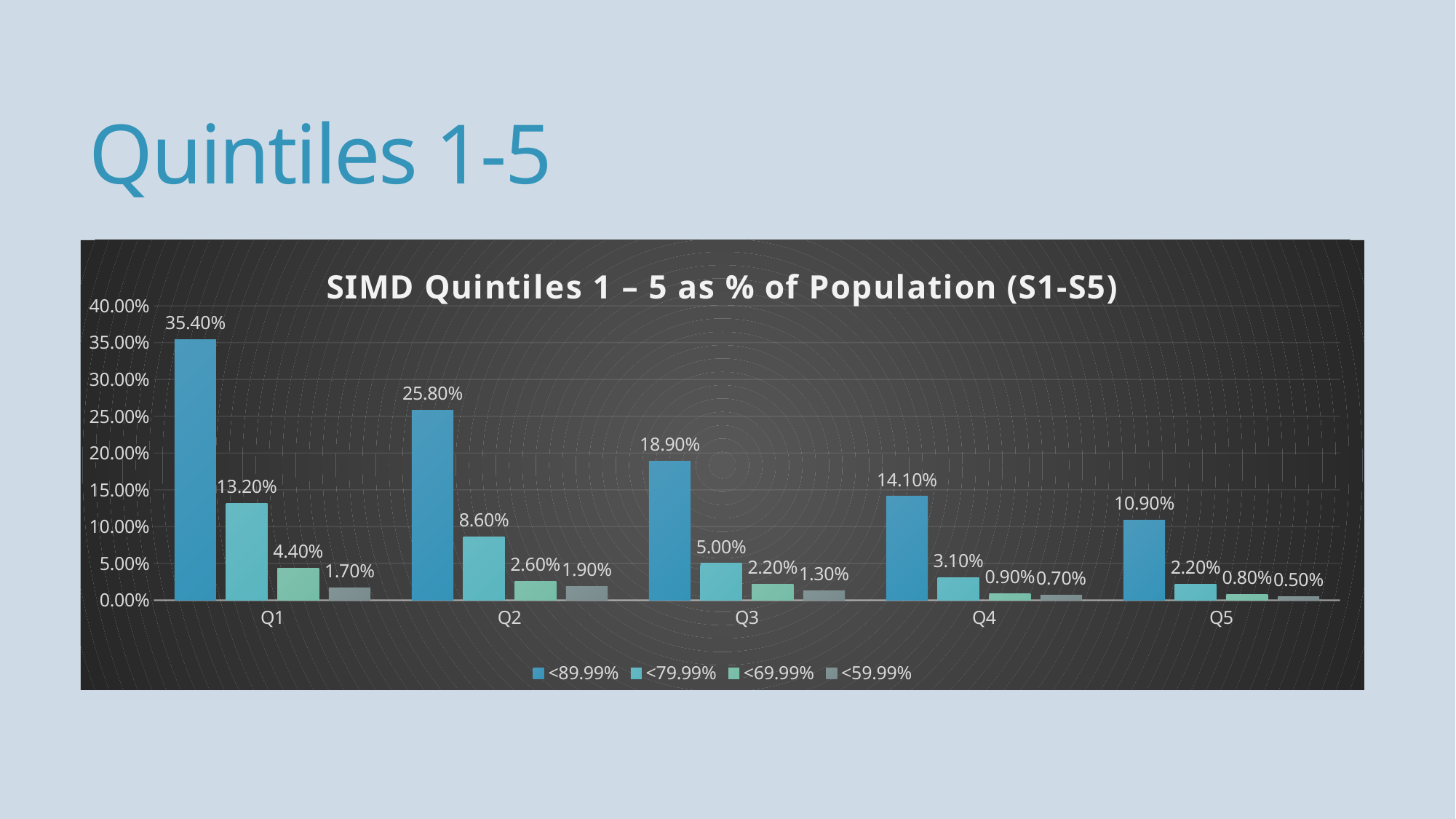
How many series does the legend list? 4 What is the value of the <59.99% series for Q5? 0.50% How many quintile categories are shown on the x axis? 5 Which quintile has the highest value in the <89.99% series? Q1 What kind of chart is shown on the slide? Bar chart What is the difference between the <89.99% values for Q1 and Q2? 9.60% What is the value of the <89.99% series for Q1? 35.40% Which quintile has the lowest value in the <79.99% series? Q5 Which is larger: the <79.99% value for Q4 or the <69.99% value for Q2? <79.99% value for Q4 What is the value of the <69.99% series for Q3? 2.20% Do the values of the <89.99% series rise or fall from Q1 to Q5? Fall What is the value of the <79.99% series for Q2? 8.60%